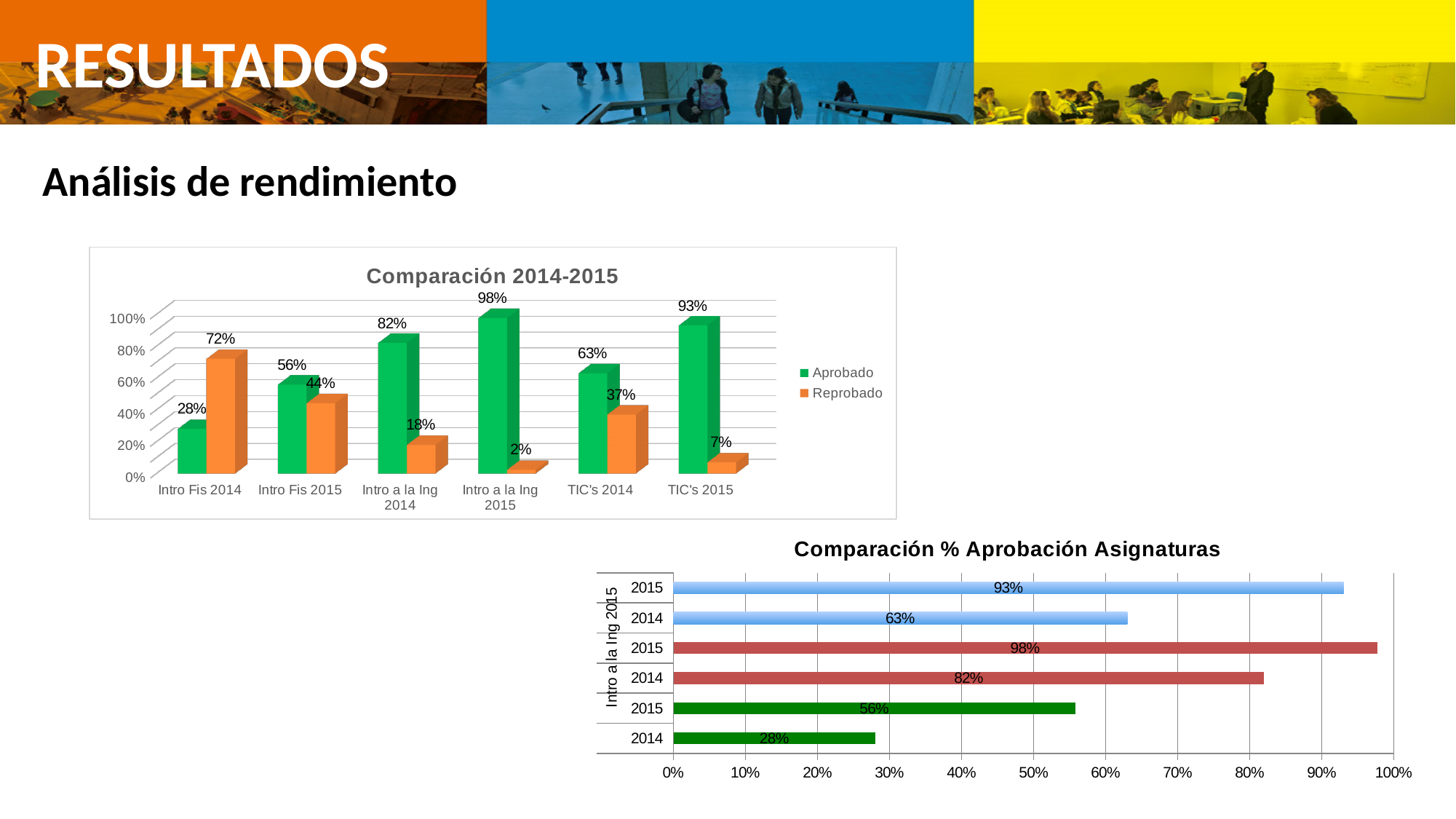
In the chart titled "Comparación 2014-2015", which category has the lowest Reprobado value? Intro a la Ing 2015 In the chart titled "Comparación 2014-2015", how many series does the legend list? 2 In the chart titled "Comparación 2014-2015", what is the difference between the Aprobado values for TIC's 2015 and TIC's 2014? 30% In the chart titled "Comparación 2014-2015", how many categories are shown on the x axis? 6 In the chart titled "Comparación 2014-2015", what is the Aprobado value for Intro Fis 2014? 28% What kind of chart is the one titled "Comparación % Aprobación Asignaturas"? Bar chart In the chart titled "Comparación 2014-2015", which is larger: the Aprobado value for Intro Fis 2015 or the Reprobado value for Intro Fis 2015? Aprobado (56%) In the chart titled "Comparación 2014-2015", which category has the highest Aprobado value? Intro a la Ing 2015 In the chart titled "Comparación 2014-2015", what is the Reprobado value for TIC's 2014? 37% In the chart titled "Comparación 2014-2015", what is the Reprobado value for Intro a la Ing 2015? 2% In the chart titled "Comparación % Aprobación Asignaturas", what is the value of the topmost bar (2015)? 93% In the chart titled "Comparación % Aprobación Asignaturas", what is the value of the bottom bar (2014)? 28%